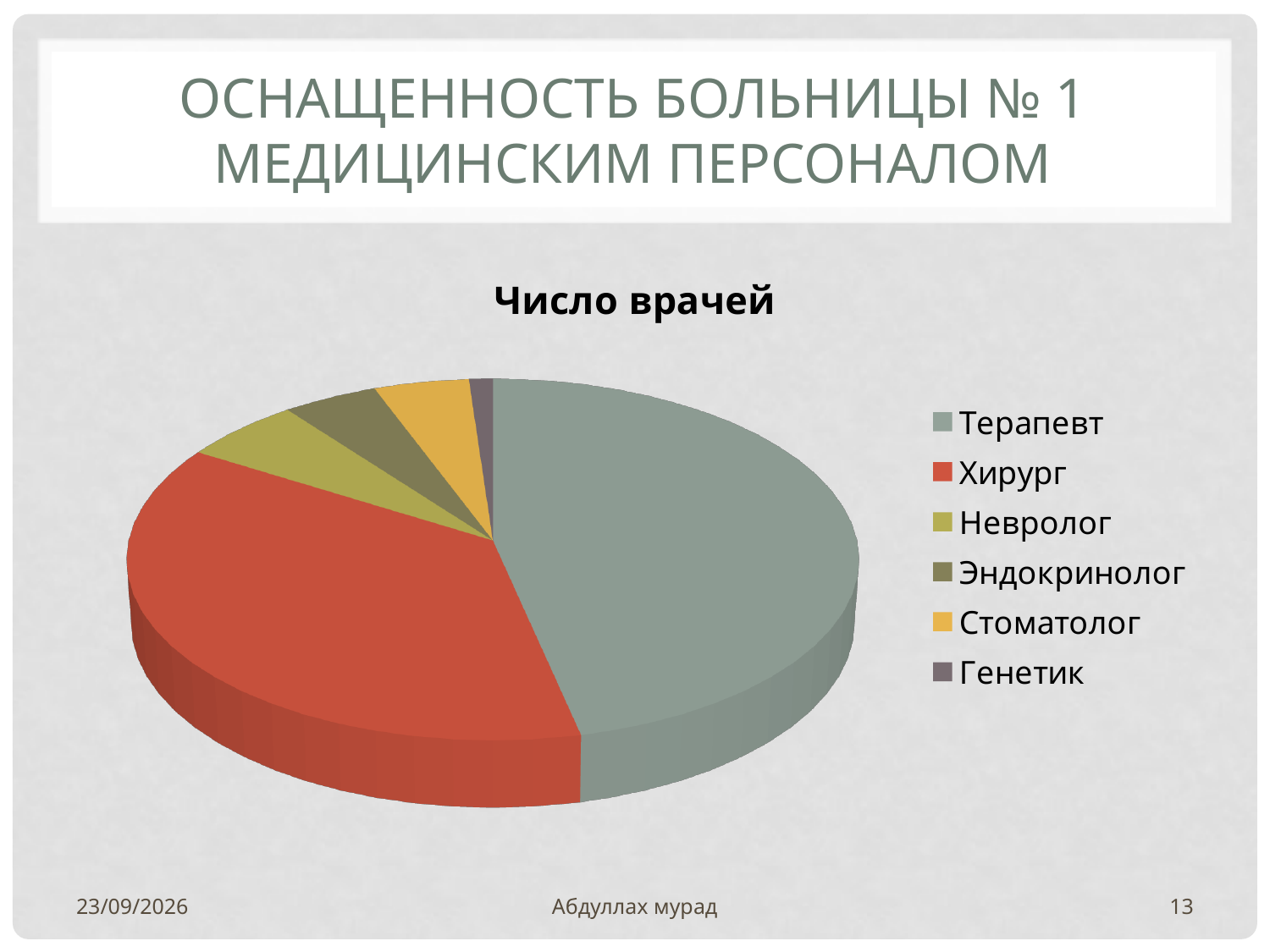
Which slice is larger in the pie chart: Хирург or Невролог? Хирург How many categories does the pie chart "Число врачей" show? 6 Which category is shown in red in the pie chart? Хирург Which slice is larger in the pie chart: Хирург or Стоматолог? Хирург What is the title of the pie chart on the slide? Число врачей Which category has the largest slice in the pie chart "Число врачей"? Терапевт What kind of chart is shown on the slide? pie chart Which category has the smallest slice in the pie chart "Число врачей"? Генетик Which slice is larger in the pie chart: Невролог or Генетик? Невролог